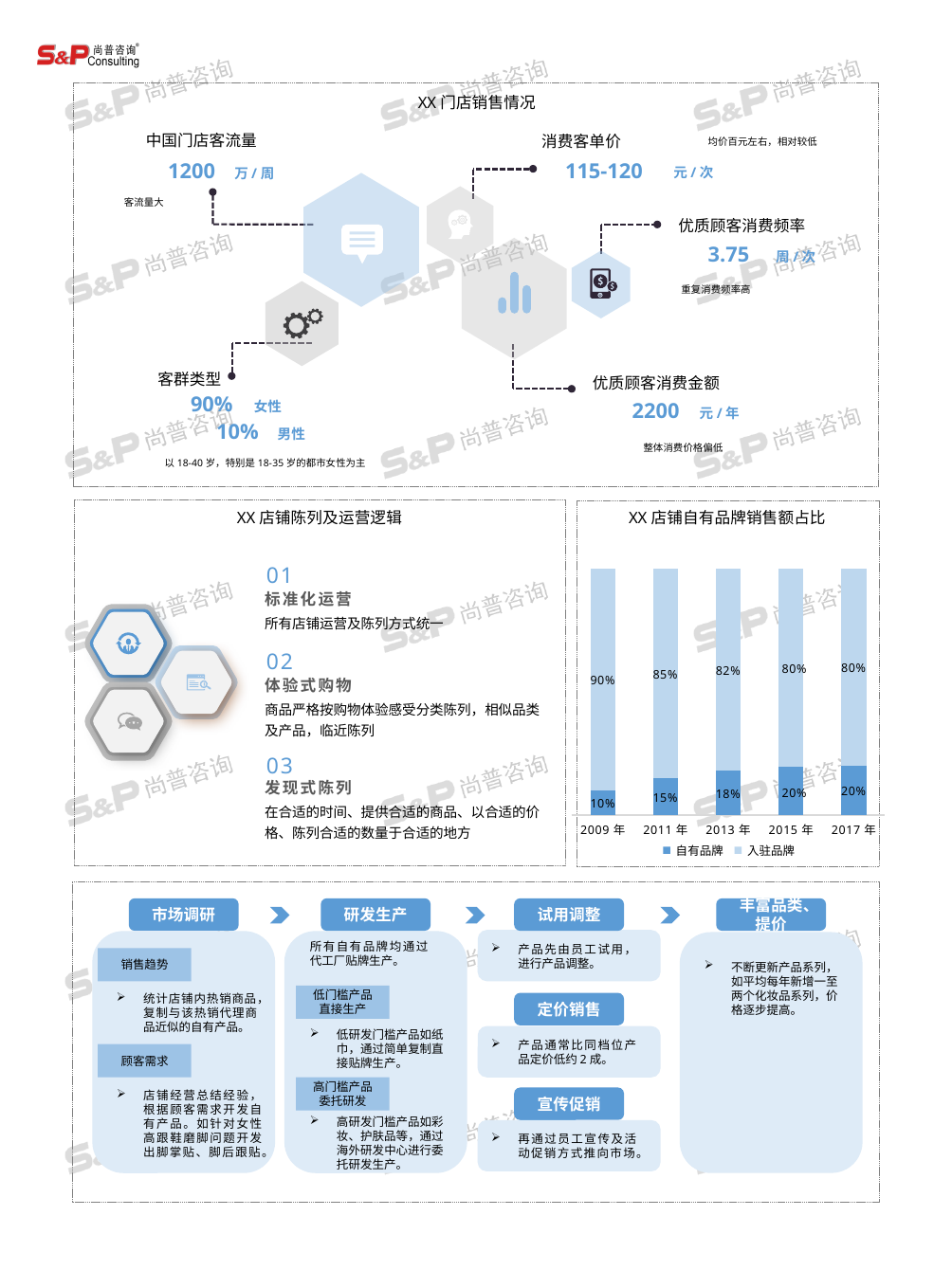
In the chart titled "XX 店铺自有品牌销售额占比", what is the value for 入驻品牌 in 2013 年? 82% In the chart titled "XX 店铺自有品牌销售额占比", what is the value for 自有品牌 in 2017 年? 20% In the chart titled "XX 店铺自有品牌销售额占比", what is the value for 自有品牌 in 2009 年? 10% In the chart titled "XX 店铺自有品牌销售额占比", does the 自有品牌 share rise or fall from 2009 年 to 2017 年? Rise What kind of chart is "XX 店铺自有品牌销售额占比"? Stacked bar chart In the chart titled "XX 店铺自有品牌销售额占比", what is the difference between the 自有品牌 values for 2015 年 and 2009 年? 10% In the chart titled "XX 店铺自有品牌销售额占比", which year has the highest value for 入驻品牌? 2009 年 In the chart titled "XX 店铺自有品牌销售额占比", which is larger: the 自有品牌 value in 2011 年 or in 2013 年? 2013 年 In the chart titled "XX 店铺自有品牌销售额占比", how many series does the legend list? 2 In the chart titled "XX 店铺自有品牌销售额占比", how many years are shown on the x axis? 5 In the chart titled "XX 店铺自有品牌销售额占比", what is the total of the stacked bar for 2011 年? 100% In the chart titled "XX 店铺自有品牌销售额占比", which year has the lowest value for 自有品牌? 2009 年